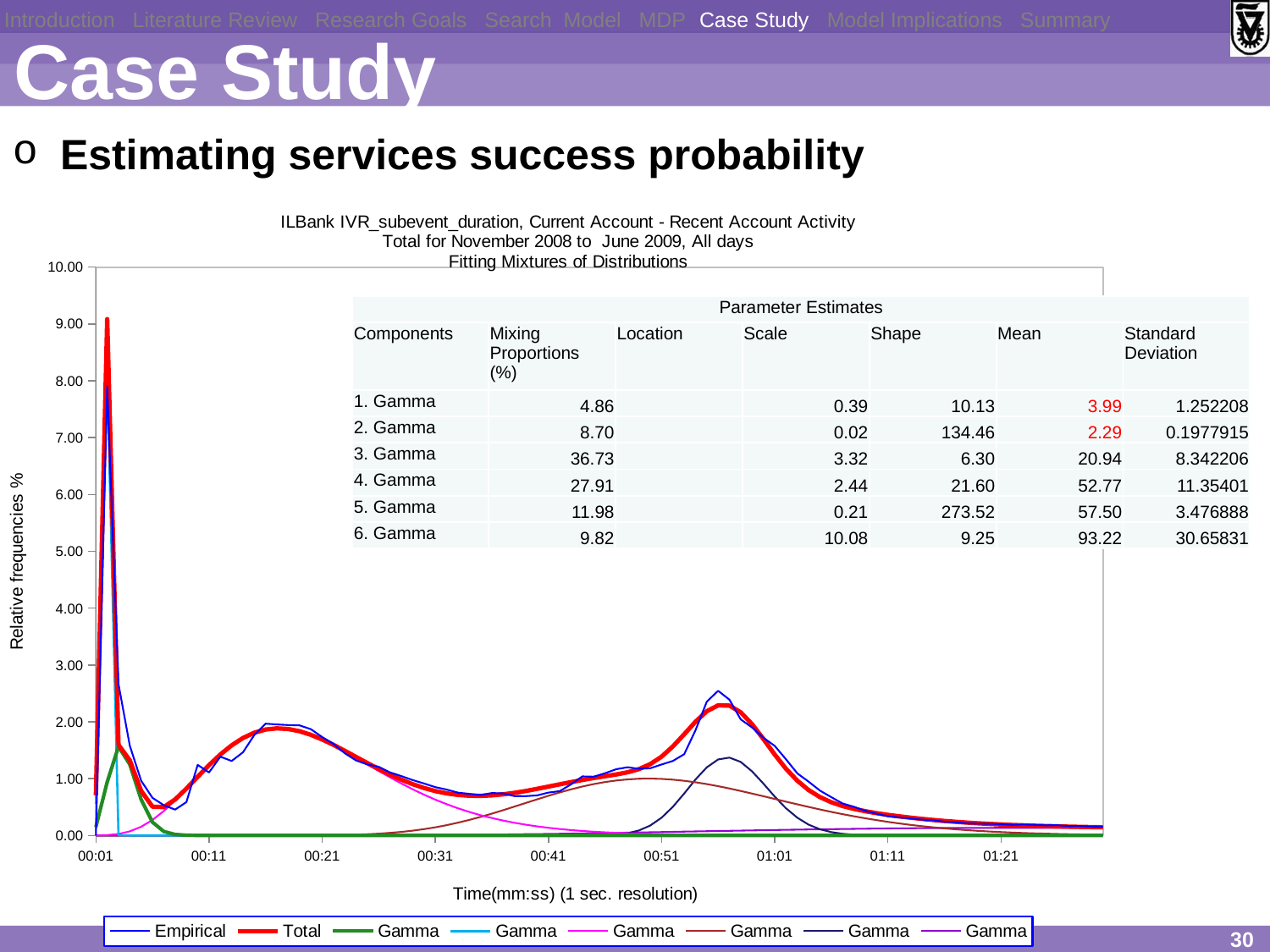
What is the label of the x axis of the chart? Time(mm:ss) (1 sec. resolution) What kind of chart is shown on the slide? line chart What is the label of the y axis of the chart? Relative frequencies % Is the value of the Total series at 00:41 greater or less than 2.00? less In the Parameter Estimates table on the chart, which component has the lowest Mean? 2. Gamma In the Parameter Estimates table on the chart, what is the Shape value of component 5. Gamma? 273.52 In the Parameter Estimates table on the chart, what is the Mixing Proportion (%) of component 3. Gamma? 36.73 Is the peak value of the Total series near 00:01 greater or less than 8.00? greater Is the value of the Total series at its hump near 00:57 greater or less than 2.00? greater How many series does the chart legend list? 8 In the Parameter Estimates table on the chart, which component has the highest Mixing Proportion (%)? 3. Gamma In the Parameter Estimates table on the chart, what is the difference between the Mean of 6. Gamma and the Mean of 5. Gamma? 35.72